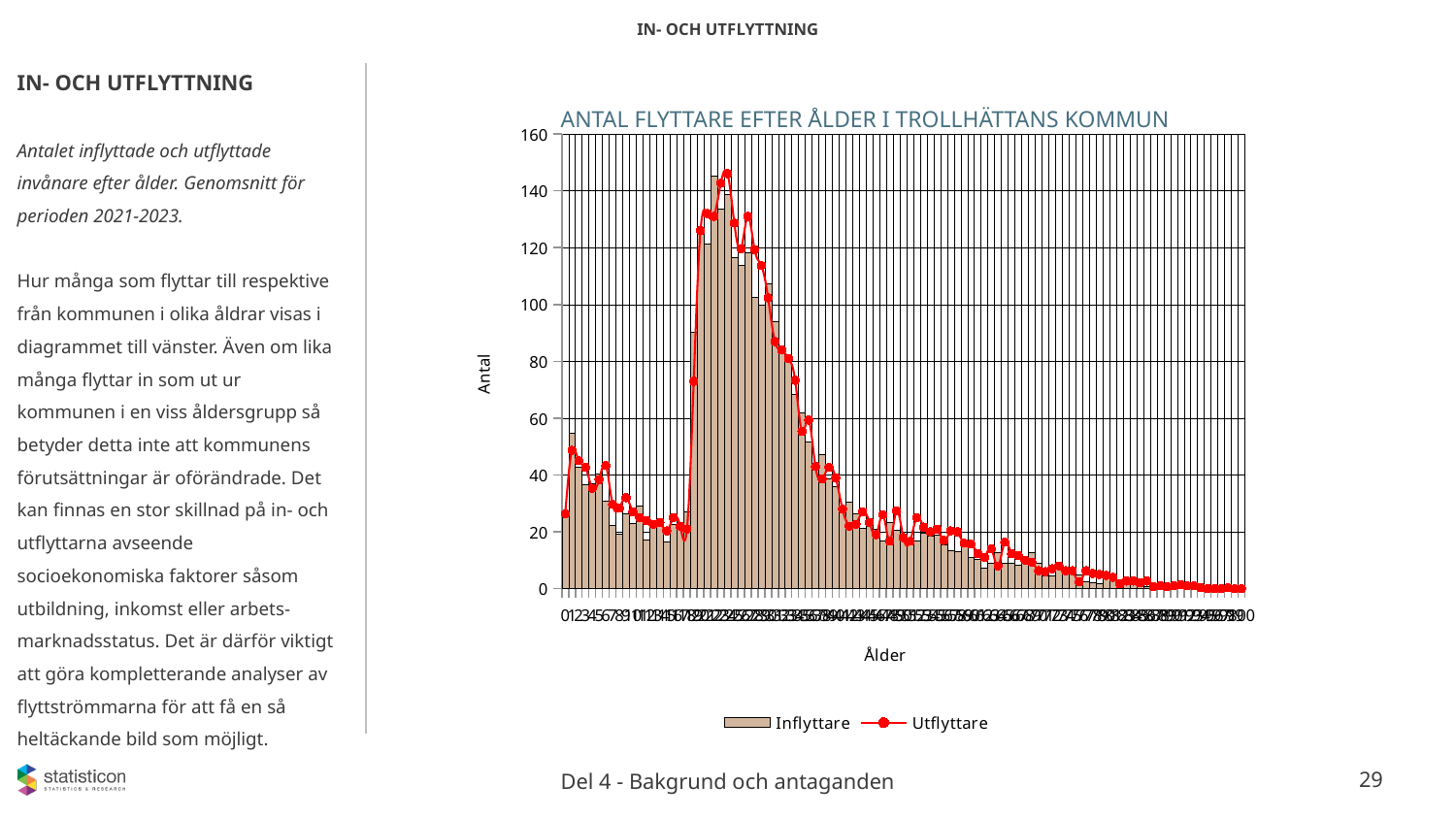
What is the title of the chart? ANTAL FLYTTARE EFTER ÅLDER I TROLLHÄTTANS KOMMUN What is the label on the vertical axis? Antal What kind of chart is this? Combined bar and line chart Is the highest Inflyttare bar greater or less than 120? greater Which series is shown as a red line with markers? Utflyttare What is the label on the horizontal axis? Ålder Is the highest value of the Utflyttare line greater or less than 140? greater What is the highest value shown on the vertical axis? 160 How many series does the chart legend list? 2 Do the values rise or fall along the x axis after the peak in the early twenties? fall Is the Utflyttare value at age 0 greater or less than 40? less